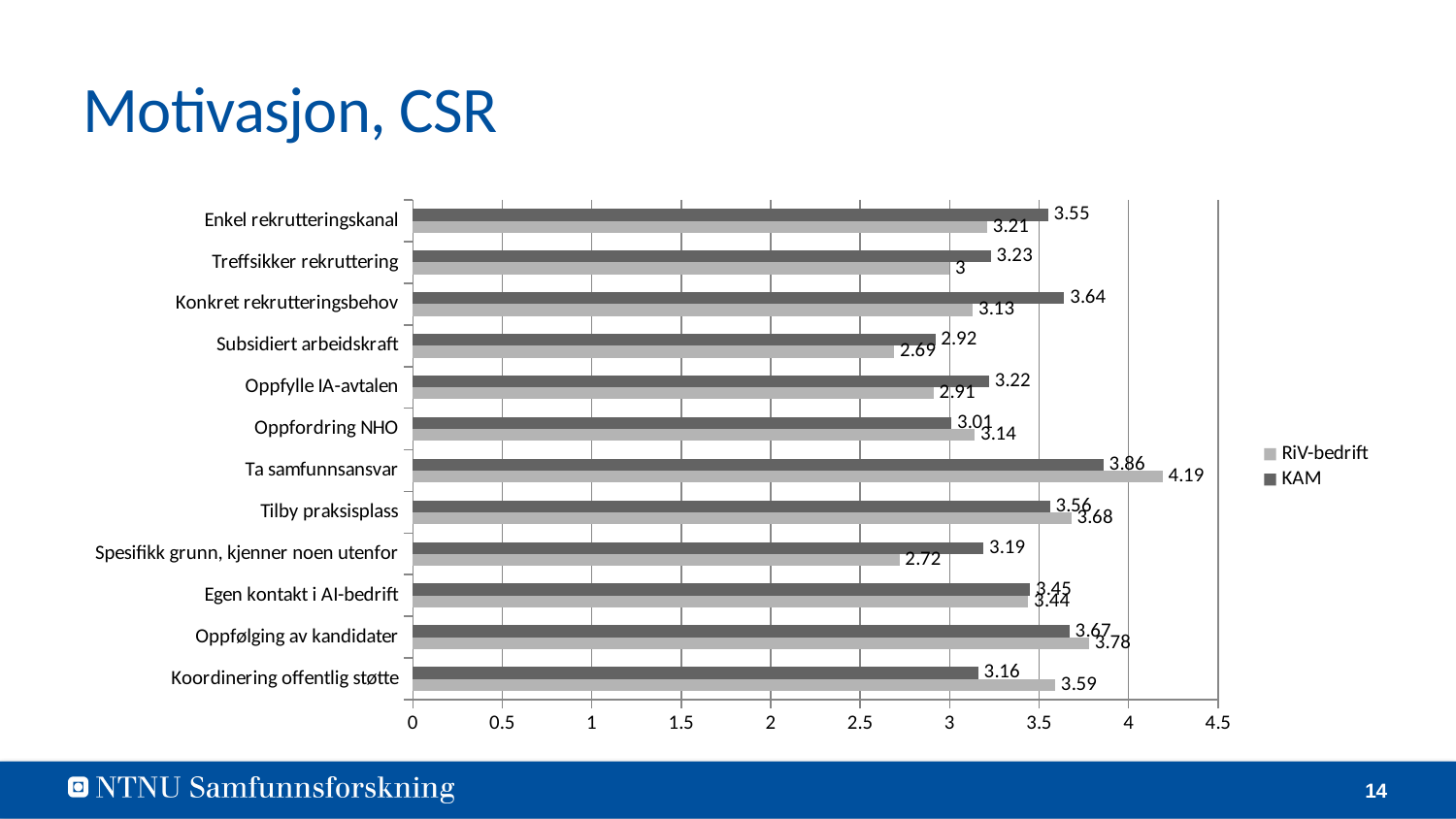
What is the KAM value for Enkel rekrutteringskanal? 3.55 Is the KAM value for Konkret rekrutteringsbehov greater or less than 3.5? greater What type of chart is shown on the slide? Bar chart Which category has the lowest KAM value? Subsidiert arbeidskraft Which series is shown in the darker gray colour? KAM For Koordinering offentlig støtte, which series has the larger value, RiV-bedrift or KAM? RiV-bedrift What is the difference between the RiV-bedrift and KAM values for Ta samfunnsansvar? 0.33 What is the RiV-bedrift value for Treffsikker rekruttering? 3 How many categories are shown on the chart? 12 How many series does the legend list? 2 Which category has the highest RiV-bedrift value? Ta samfunnsansvar What is the RiV-bedrift value for Ta samfunnsansvar? 4.19